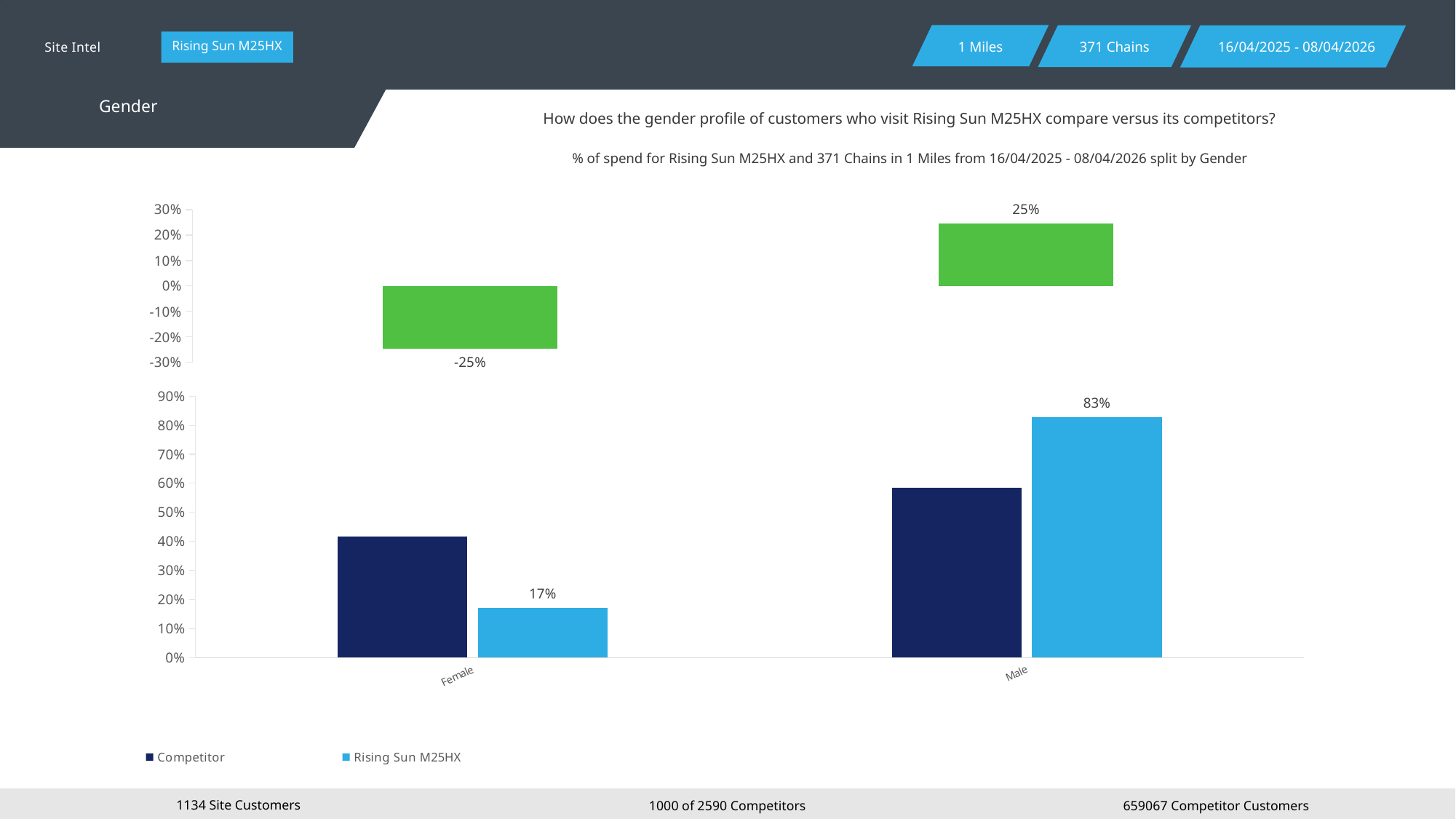
How many categories are shown on the x axis of the bottom chart? 2 How many series does the legend of the bottom chart list? 2 In the bottom chart, what is the difference between the Rising Sun M25HX values for Male and Female? 66% In the bottom chart, what is the value for Rising Sun M25HX for Female? 17% In the bottom chart, is the Competitor value for Male greater or less than 50%? greater In the bottom chart, what is the value for Rising Sun M25HX for Male? 83% In the bottom chart, for Female, which series is larger, Competitor or Rising Sun M25HX? Competitor In the bottom chart, is the Competitor value for Female greater or less than 50%? less In the top chart, what is the value shown for Female? -25% In the bottom chart, which category has the higher Rising Sun M25HX value, Female or Male? Male What type of chart is the bottom chart? Bar chart In the top chart, what is the value shown for Male? 25%